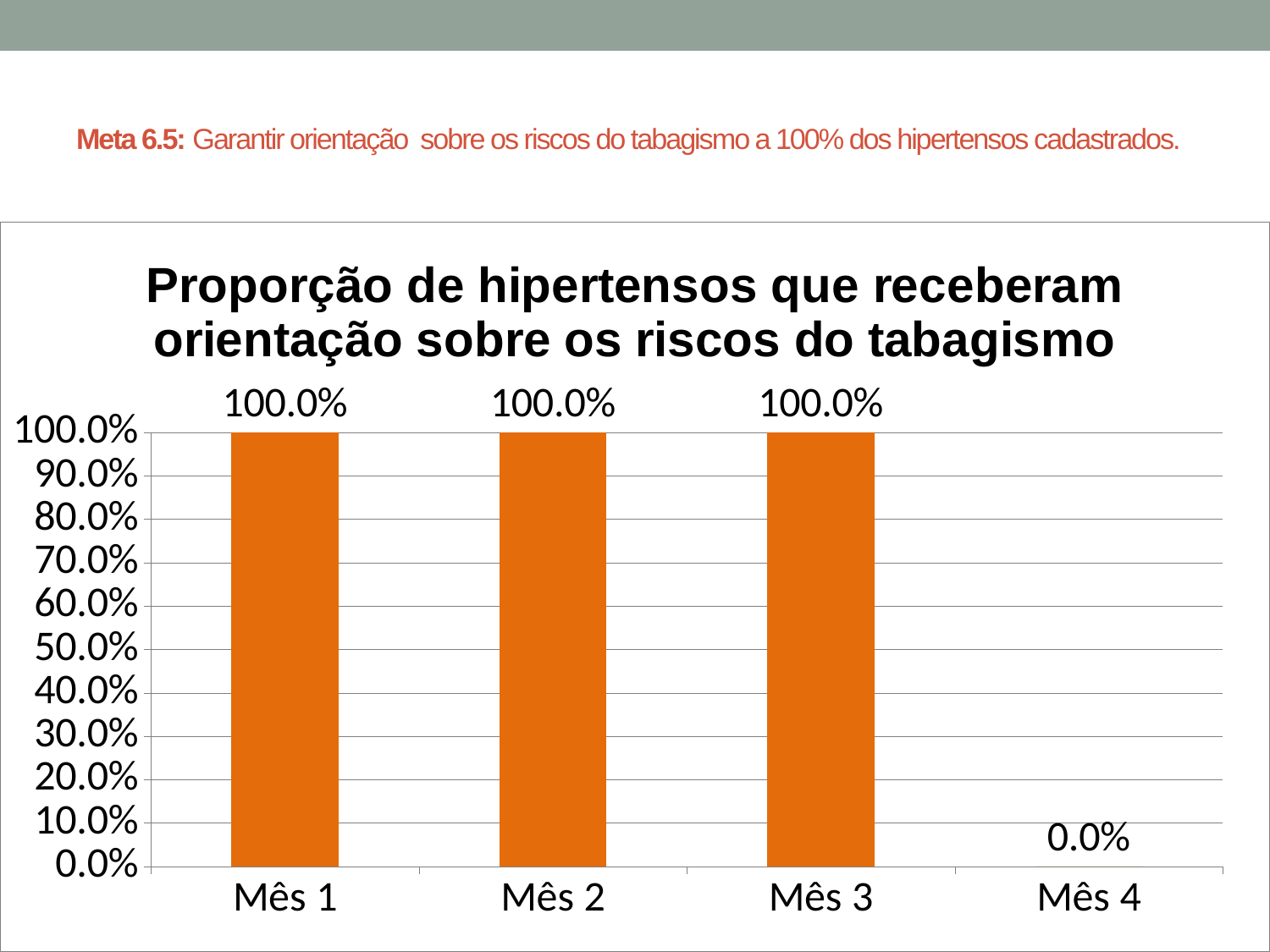
Which is larger, the value for Mês 3 or the value for Mês 4? Mês 3 What colour are the bars in the chart? orange What is the value for Mês 4? 0.0% Which month has the lowest value? Mês 4 What is the value for Mês 3? 100.0% What kind of chart is shown? bar chart What is the difference between the values for Mês 2 and Mês 4? 100.0% Is the value for Mês 2 greater or less than 50.0%? greater What is the title of the chart? Proporção de hipertensos que receberam orientação sobre os riscos do tabagismo What is the value for Mês 1? 100.0% How many months are shown on the x axis? 4 How many months have a value of 100.0%? 3